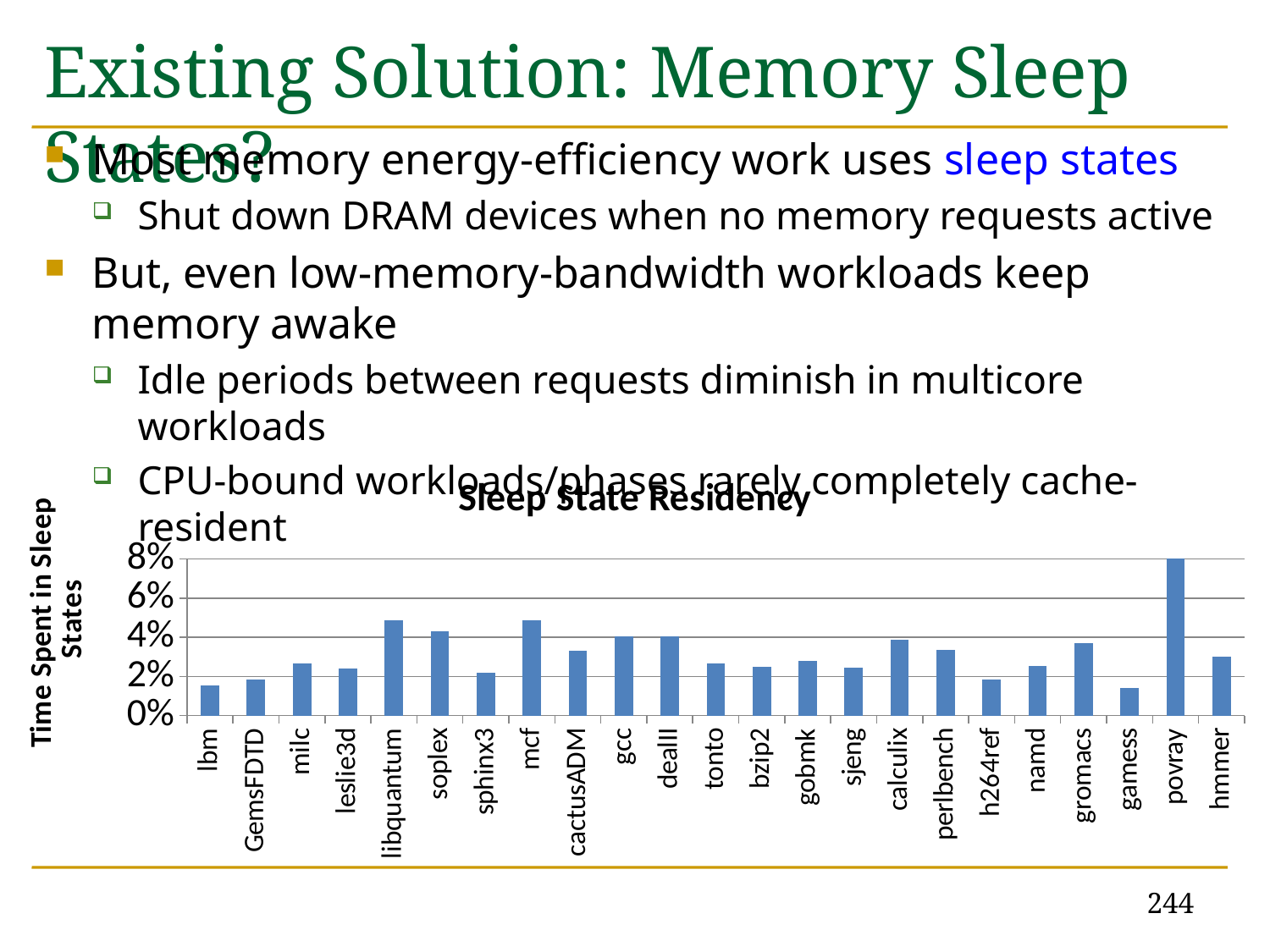
What is the title of the chart? Sleep State Residency Which has a larger value, libquantum or sphinx3? libquantum Which has a larger value, povray or mcf? povray Is the value for povray greater or less than 6%? greater How many workloads (categories) are plotted in the chart? 23 What is the label on the vertical axis of the chart? Time Spent in Sleep States Is the value for lbm greater or less than 2%? less What type of chart is shown on the slide? bar chart Is the value for cactusADM greater or less than 4%? less Which workload has the highest time spent in sleep states? povray